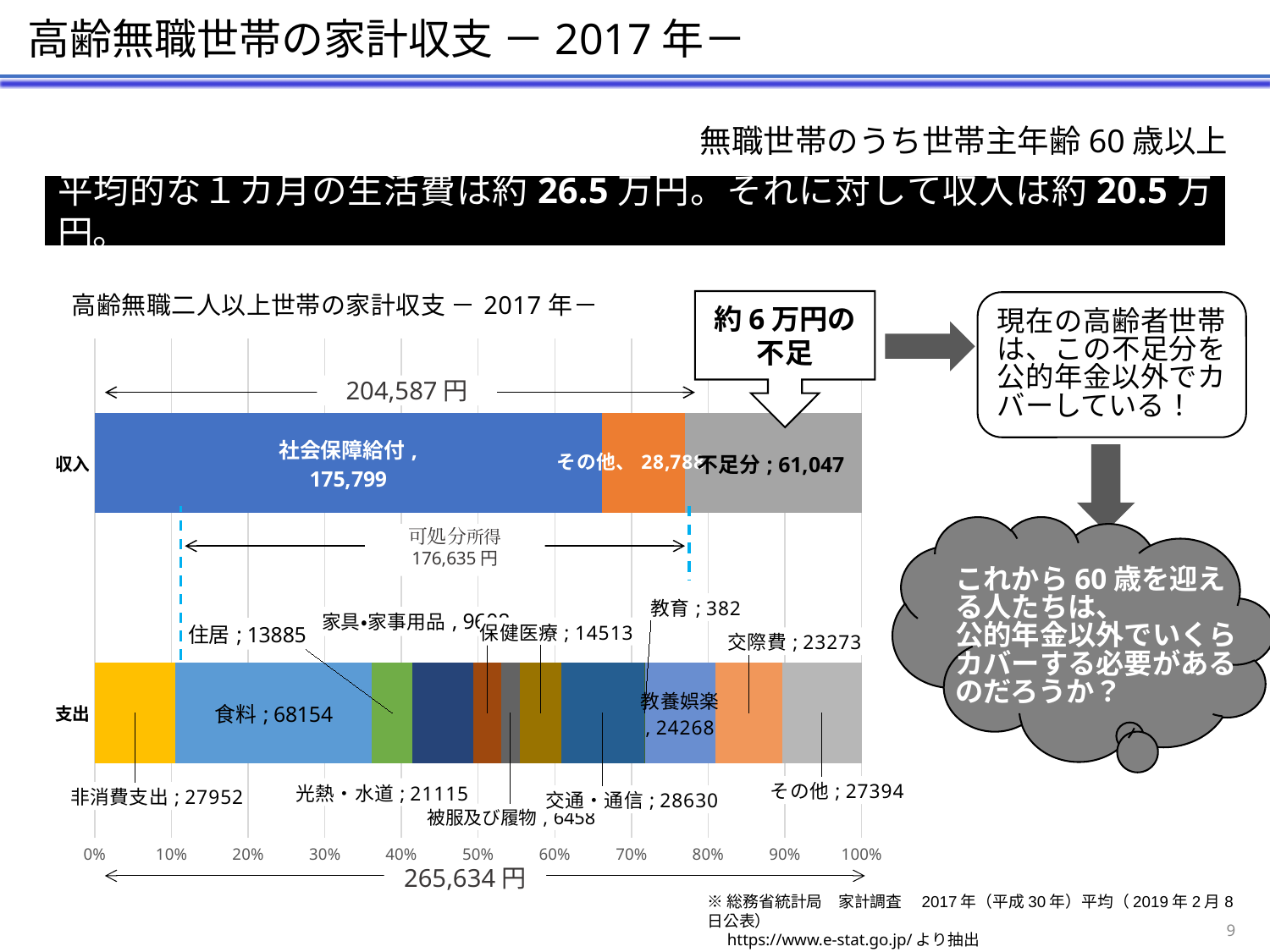
What is the value of 社会保障給付 in the 収入 bar? 175,799 What is the value of 食料 in the 支出 bar? 68154 Which category in the 支出 bar has the largest value? 食料 What is the value of 教育 in the 支出 bar? 382 What is the difference between 非消費支出 and 光熱・水道 in the 支出 bar? 6837 Which is larger in the 支出 bar, 交際費 or 教養娯楽? 教養娯楽 What total amount is shown for the 支出 bar? 265,634円 What type of chart is shown on the slide? Stacked bar chart Which category in the 支出 bar has the smallest value? 教育 What is the value of 不足分 in the 収入 bar? 61,047 What is the value of 交通・通信 in the 支出 bar? 28630 What is the title of the chart? 高齢無職二人以上世帯の家計収支 － 2017年－